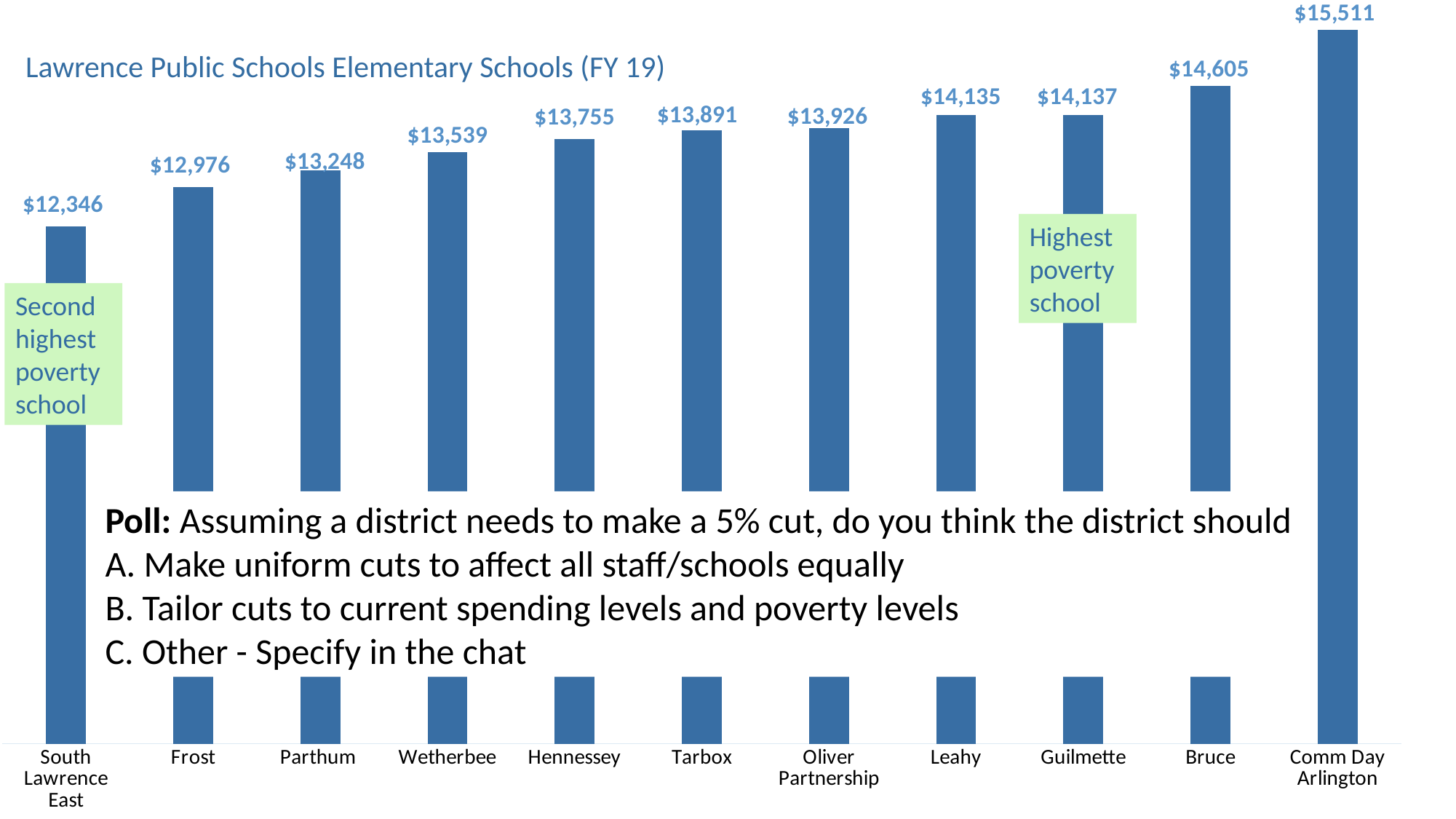
What is the difference between the values for Bruce and Wetherbee? $1,066 Which is larger, the value for Frost or the value for Hennessey? Hennessey What is the value for South Lawrence East? $12,346 What is the value for Guilmette? $14,137 What is the difference between the values for Comm Day Arlington and South Lawrence East? $3,165 Do the values rise or fall from left to right across the schools? Rise Which school has the lowest value? South Lawrence East What is the value for Comm Day Arlington? $15,511 What is the value for Tarbox? $13,891 Which school has the highest value? Comm Day Arlington What kind of chart is shown on the slide? Bar chart How many schools are shown in the chart? 11